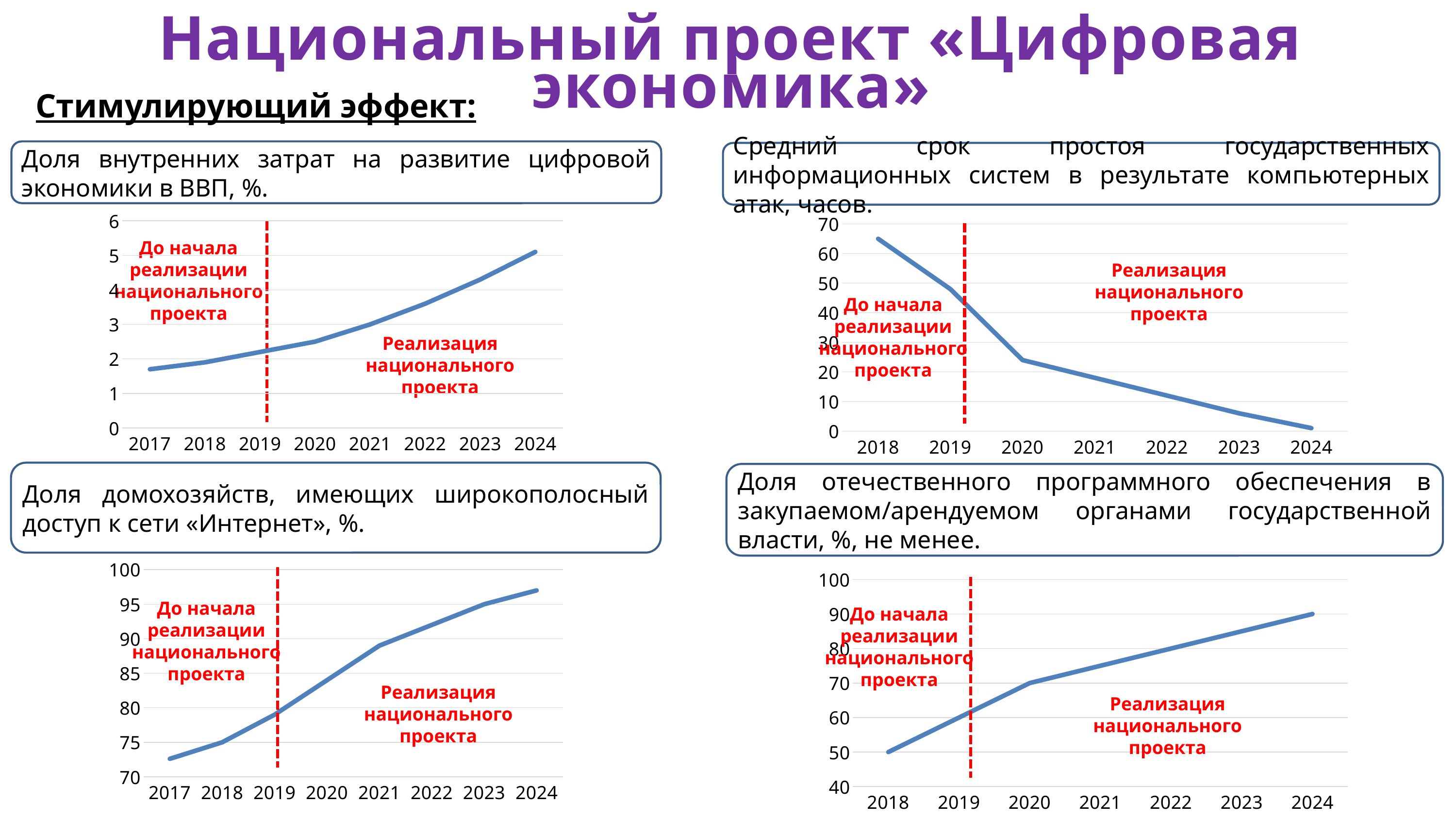
In the chart «Доля домохозяйств, имеющих широкополосный доступ к сети «Интернет», %», is the value for 2024 greater or less than 95? greater In the chart «Средний срок простоя государственных информационных систем в результате компьютерных атак, часов», do the values rise or fall from 2018 to 2024? fall In the chart «Доля отечественного программного обеспечения в закупаемом/арендуемом органами государственной власти, %, не менее», is the value for 2021 greater or less than 70? greater In the chart «Доля внутренних затрат на развитие цифровой экономики в ВВП, %», is the value for 2024 greater or less than 4? greater In the chart «Доля внутренних затрат на развитие цифровой экономики в ВВП, %», do the values rise or fall from 2017 to 2024? rise In the chart «Средний срок простоя государственных информационных систем в результате компьютерных атак, часов», how many years are shown on the x axis? 7 In the chart «Доля домохозяйств, имеющих широкополосный доступ к сети «Интернет», %», which year has the lowest value? 2017 In the chart «Доля отечественного программного обеспечения в закупаемом/арендуемом органами государственной власти, %, не менее», which is larger, the value for 2019 or the value for 2022? 2022 What kind of chart is the chart titled «Доля внутренних затрат на развитие цифровой экономики в ВВП, %»? line chart In the chart «Доля внутренних затрат на развитие цифровой экономики в ВВП, %», how many years are shown on the x axis? 8 In the chart «Средний срок простоя государственных информационных систем в результате компьютерных атак, часов», which year has the highest value? 2018